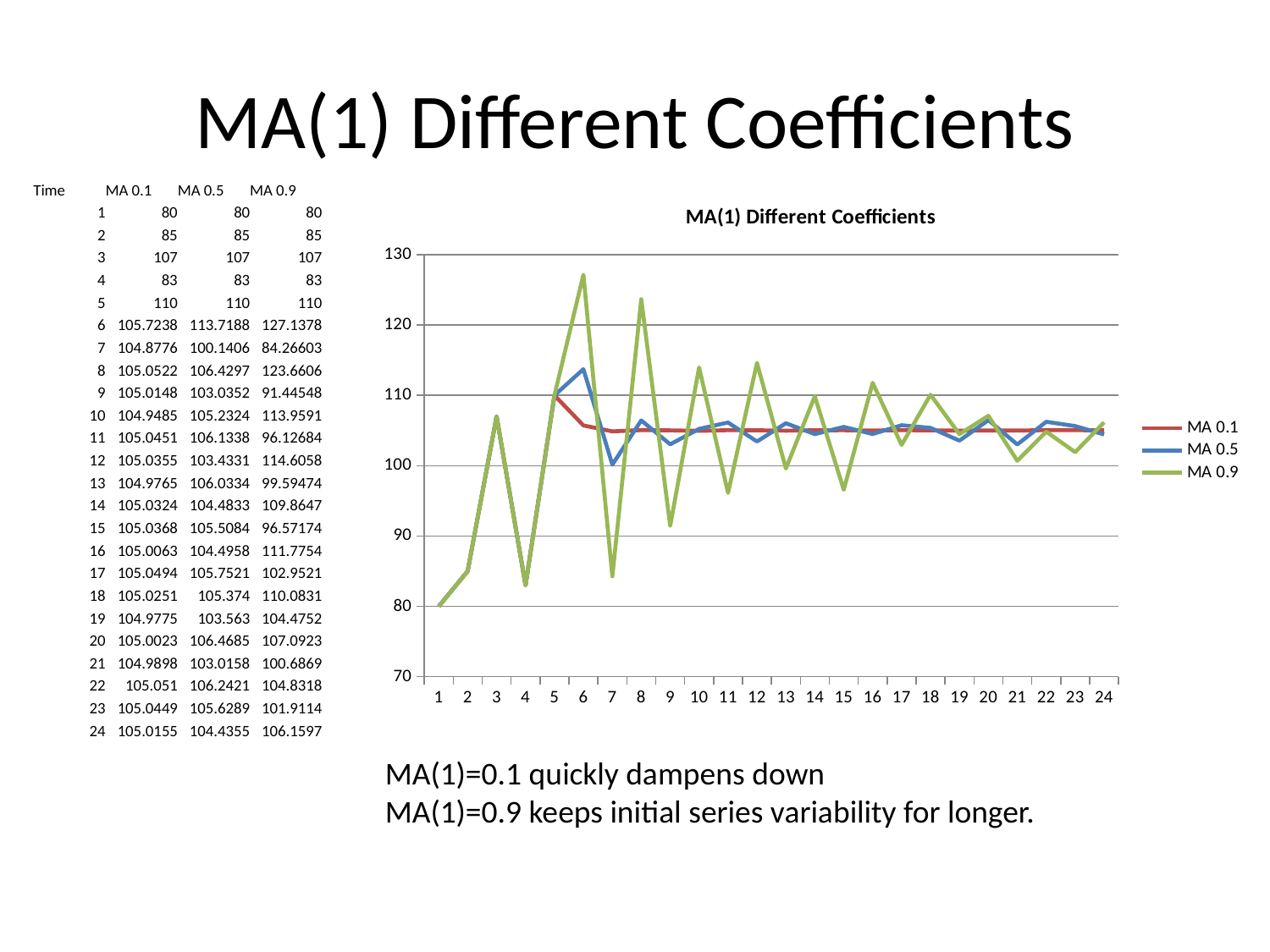
What is the value of MA 0.1 at time 24? 105.0155 What is the difference between MA 0.9 and MA 0.1 at time 6? 21.414 At time 6, which is larger: MA 0.5 or MA 0.1? MA 0.5 How many time points are plotted along the x axis? 24 How many series does the chart legend list? 3 What is the value of MA 0.5 at time 7? 100.1406 Is the value for MA 0.9 at time 7 greater or less than 90? less What type of chart is shown on the slide? line chart What is the title of the chart? MA(1) Different Coefficients At which time point do all three series have their lowest value? 1 What is the value of MA 0.9 at time 6? 127.1378 At which time point does the MA 0.9 series reach its highest value? 6